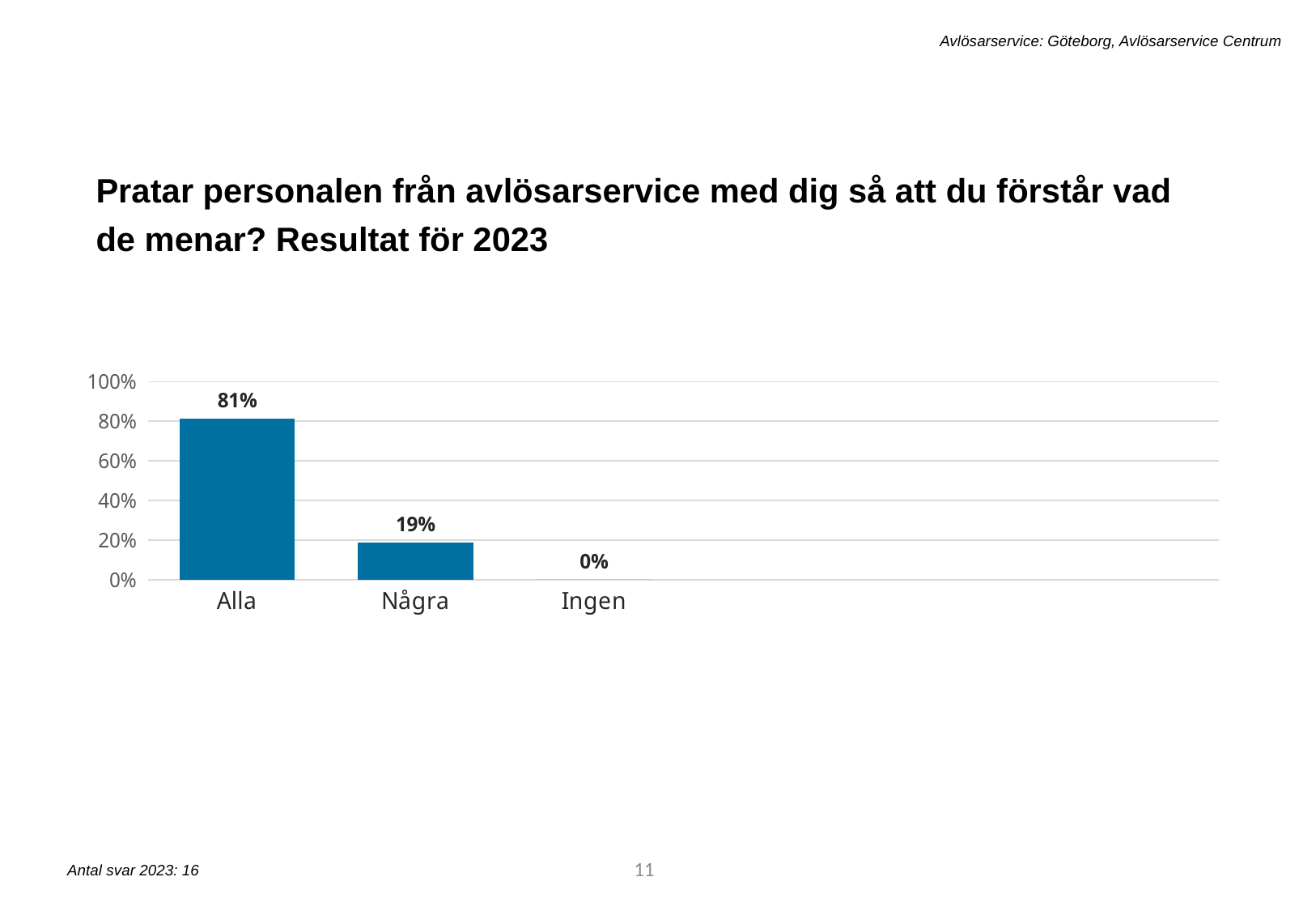
Is the value for Alla greater or less than 60%? greater What kind of chart is shown on the slide? bar chart What is the highest value shown on the y axis? 100% Do the values rise or fall from left to right along the x axis? fall Which is larger, the value for Några or the value for Ingen? Några What is the difference between the values for Alla and Några? 62% What is the value for Alla? 81% Which category has the lowest value? Ingen What is the value for Ingen? 0% What is the value for Några? 19% How many categories are shown on the x axis? 3 Which category has the highest value? Alla